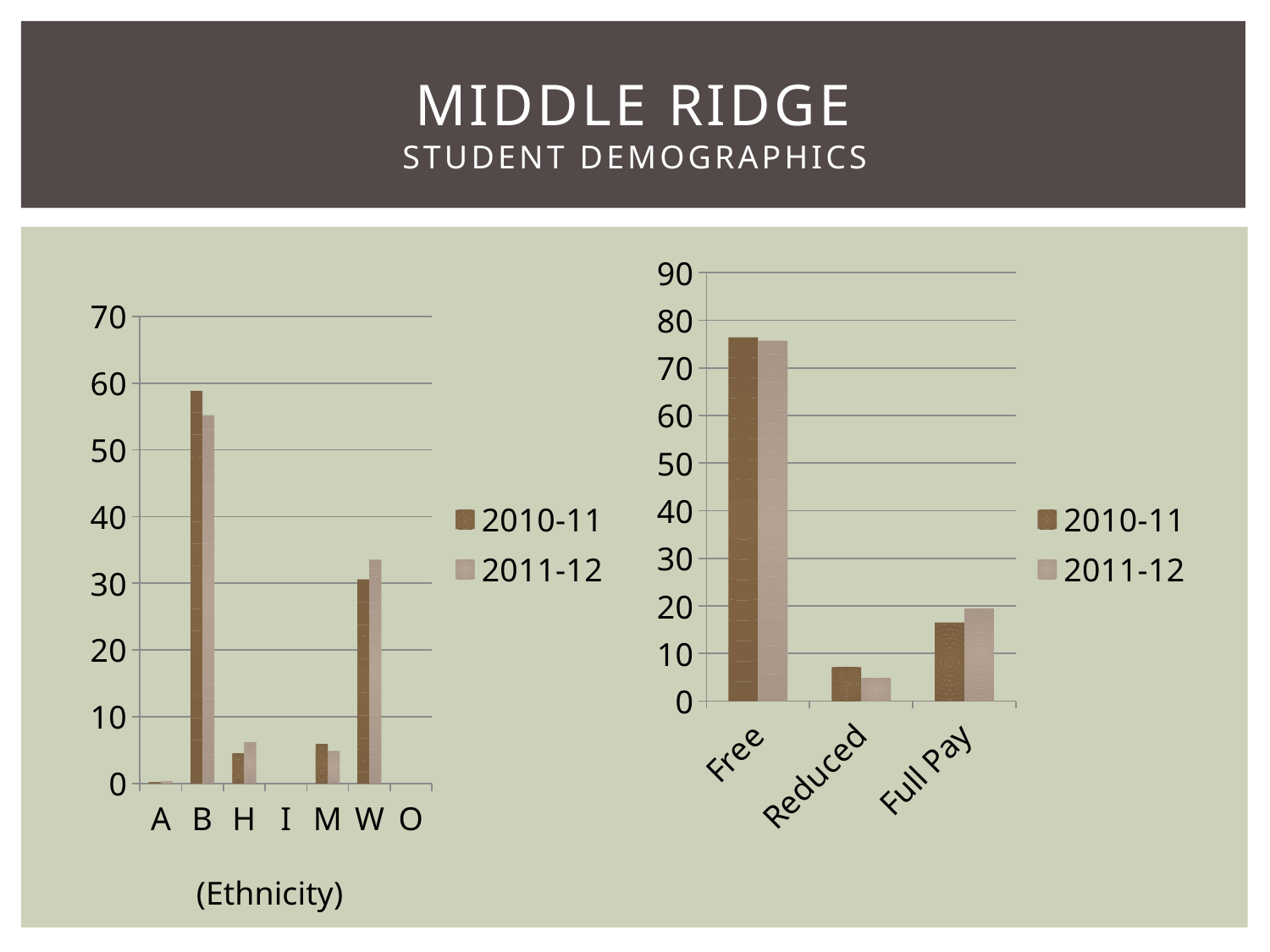
What are the two legend entries shown for the right chart? 2010-11 and 2011-12 What kind of chart is the Ethnicity chart on the left of the slide? bar chart In the left (Ethnicity) chart, is the 2010-11 value for B greater or less than 50? greater In the left (Ethnicity) chart, which is larger for 2011-12: B or W? B In the right chart, which category has the lowest 2011-12 value? Reduced How many ethnicity categories are shown on the x axis of the left chart? 7 In the right chart, is the 2010-11 value for Free greater or less than 70? greater In the right chart, which category has the highest 2010-11 value? Free How many categories are shown on the x axis of the right chart (Free, Reduced, Full Pay)? 3 In the left (Ethnicity) chart, is the 2011-12 value for W greater or less than 30? greater How many series does the legend of the left (Ethnicity) chart list? 2 In the left (Ethnicity) chart, which category has the highest 2010-11 value? B